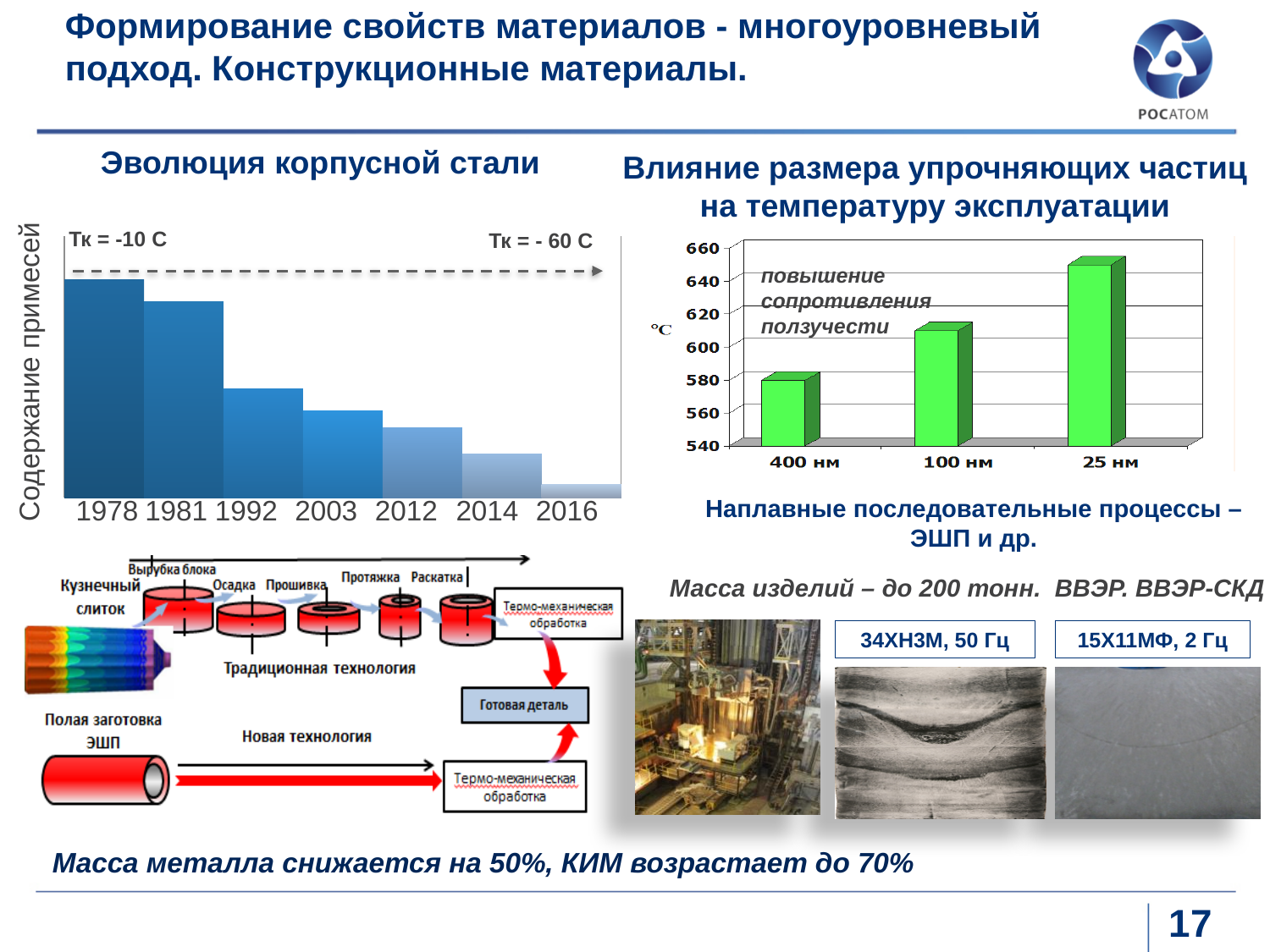
What kind of chart is the 'Влияние размера упрочняющих частиц на температуру эксплуатации' chart? bar chart In the 'Эволюция корпусной стали' chart, which bar is taller, 1981 or 1992? 1981 In the 'Влияние размера упрочняющих частиц на температуру эксплуатации' chart, which particle size has the lowest temperature? 400 нм In the 'Эволюция корпусной стали' chart, how many years are shown on the x axis? 7 In the 'Влияние размера упрочняющих частиц на температуру эксплуатации' chart, is the value for 25 нм greater or less than 640? greater In the 'Влияние размера упрочняющих частиц на температуру эксплуатации' chart, which particle size has the highest temperature? 25 нм In the 'Эволюция корпусной стали' chart, which year has the highest bar? 1978 In the 'Эволюция корпусной стали' chart, do the bars rise or fall from 1978 to 2016? fall What kind of chart is the 'Эволюция корпусной стали' chart on the left? bar chart In the 'Влияние размера упрочняющих частиц на температуру эксплуатации' chart, is the value for 400 нм greater or less than 600? less In the 'Эволюция корпусной стали' chart, which year has the lowest bar? 2016 In the 'Влияние размера упрочняющих частиц на температуру эксплуатации' chart, how many particle sizes are shown on the x axis? 3